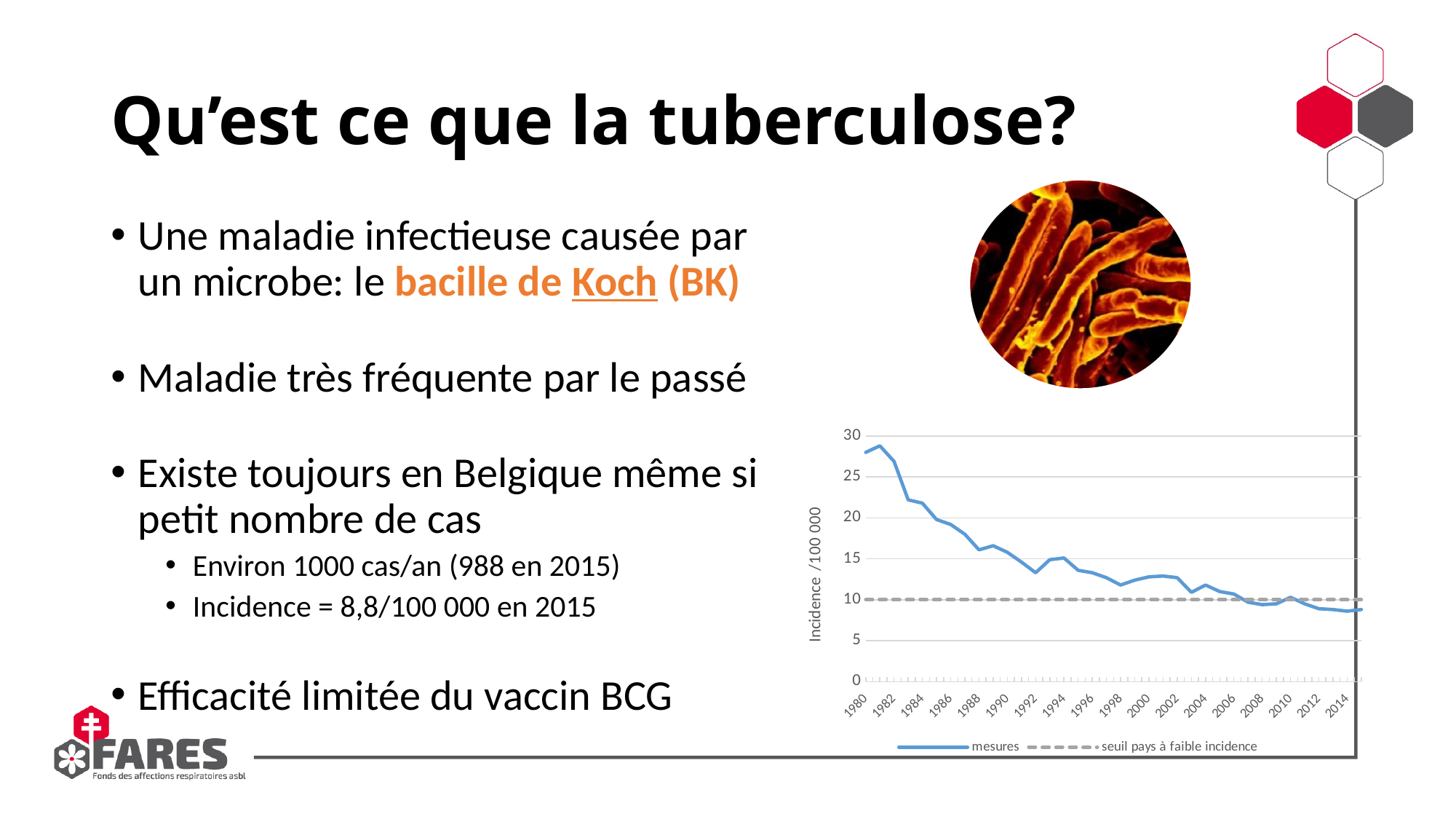
What kind of chart is shown on the slide? line chart Is the 'mesures' value for 2014 greater or less than 10? less Which year has the larger 'mesures' value, 1992 or 2006? 1992 Do the 'mesures' values rise or fall from 1980 to 2014? fall Which year has the larger 'mesures' value, 1980 or 2014? 1980 What are the two series named in the chart legend? mesures; seuil pays à faible incidence Is the 'mesures' value for 1984 greater or less than 20? greater Is the 'mesures' value for 1980 greater or less than 25? greater At what incidence level is the dashed 'seuil pays à faible incidence' line drawn? 10 What is the title of the chart's vertical axis? Incidence /100 000 How many series does the chart legend list? 2